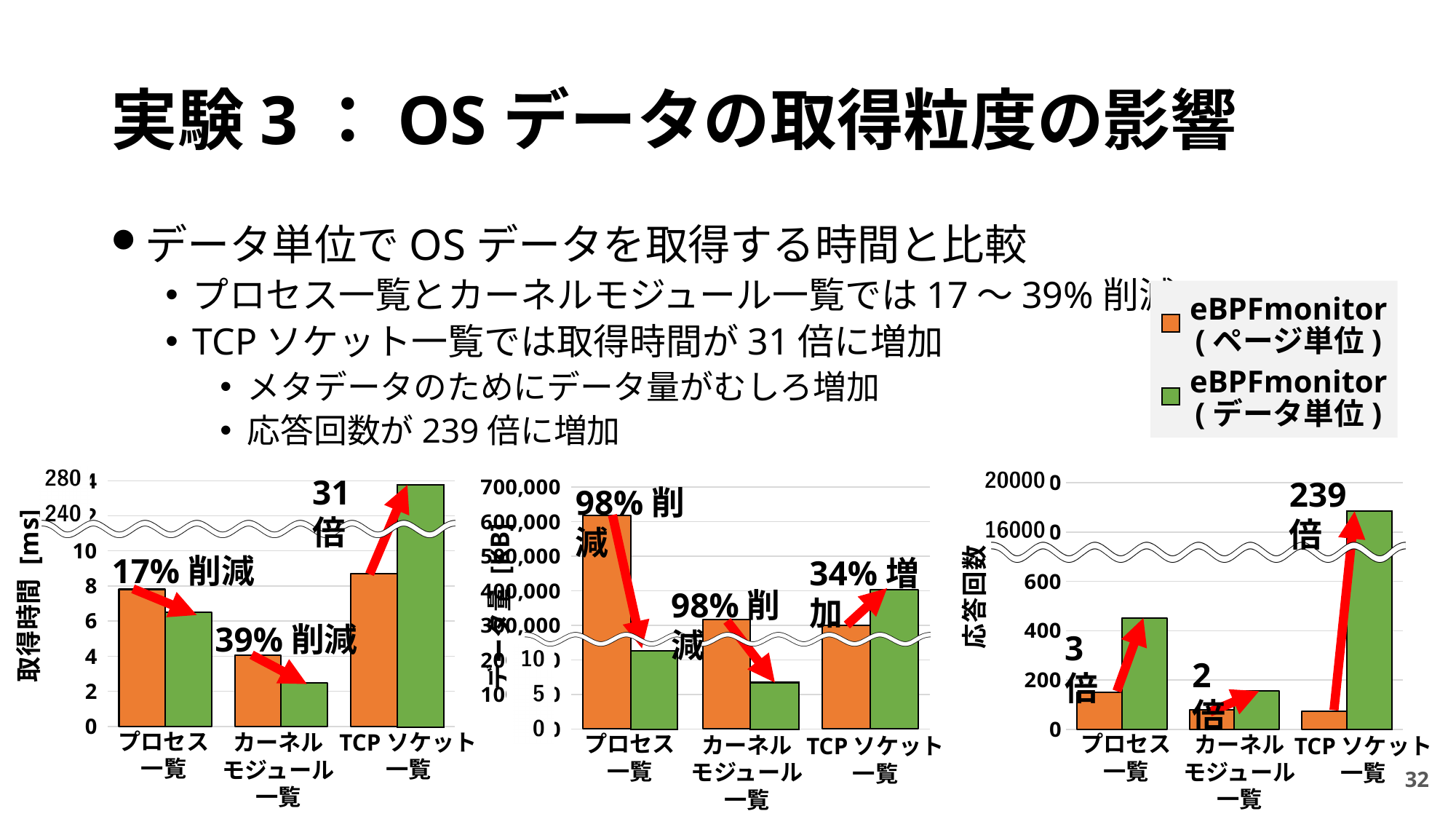
How many categories are shown on the x axis of the right chart (応答回数)? 3 In the right chart (応答回数), is the eBPFmonitor (ページ単位) value for プロセス一覧 greater or less than 200? less In the left chart (取得時間 [ms]), is the eBPFmonitor (ページ単位) value for プロセス一覧 greater or less than 6? greater In the left chart (取得時間 [ms]), is the eBPFmonitor (データ単位) value for カーネルモジュール一覧 greater or less than 4? less In the left chart (取得時間 [ms]), which category has the highest bar? TCP ソケット一覧 In the left chart (取得時間 [ms]), for TCP ソケット一覧, which series has the larger value: eBPFmonitor (ページ単位) or eBPFmonitor (データ単位)? eBPFmonitor (データ単位) How many series does the legend list? 2 In the middle chart (データ量 [B]), which category has the highest bar? プロセス一覧 What kind of chart is the left chart (取得時間 [ms])? bar chart Which colour represents eBPFmonitor (ページ単位) in the charts? orange